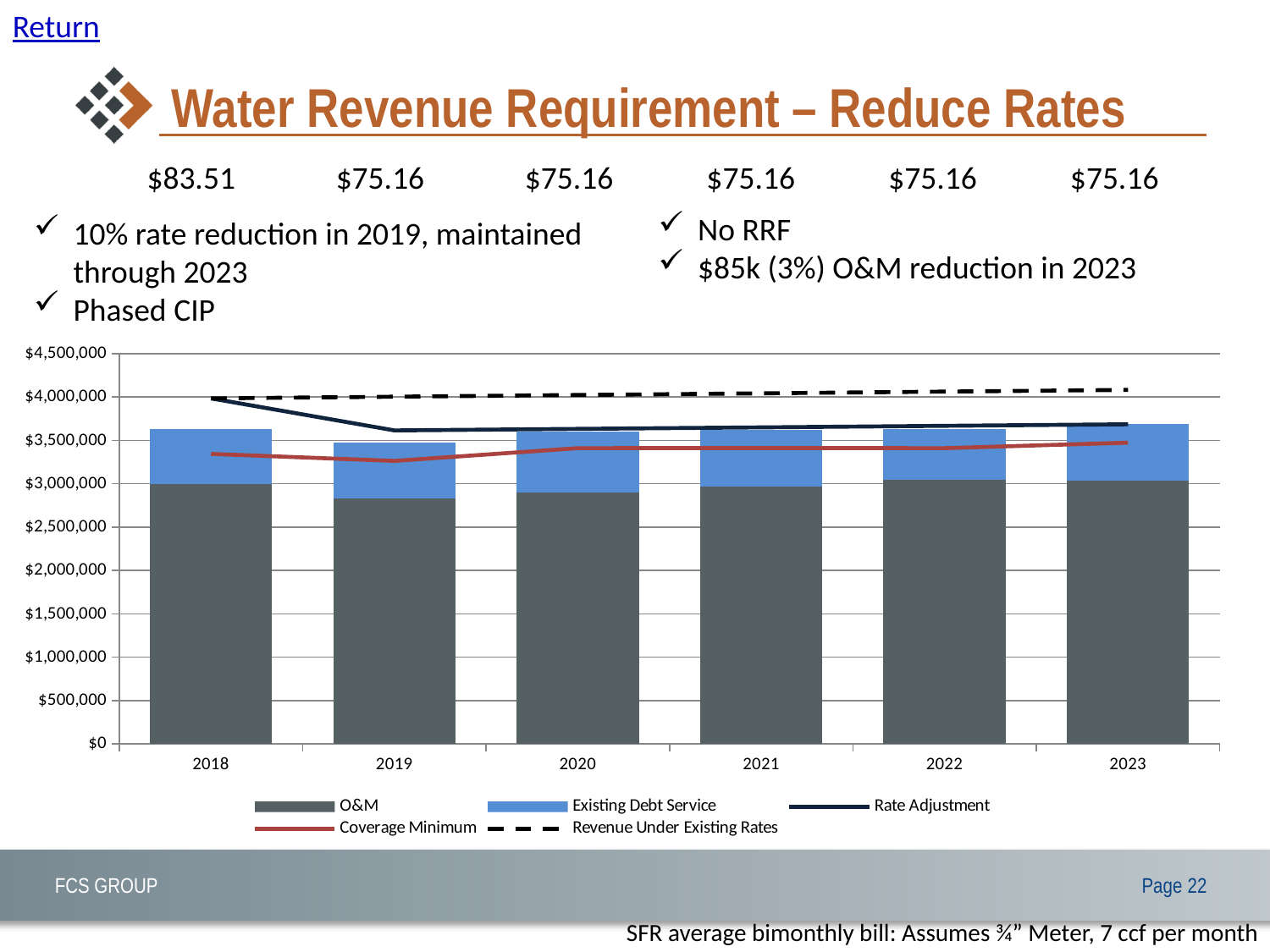
How many series does the chart legend list? 5 What kind of chart is shown on the slide? combination bar and line chart Which is larger, the O&M value for 2019 or for 2022? 2022 Which year has the lowest total stacked bar (O&M plus Existing Debt Service)? 2019 Which year has the lowest O&M value? 2019 Is the O&M value for 2019 greater or less than $3,000,000? less Is the Revenue Under Existing Rates value for 2023 greater or less than $4,000,000? greater How many years are shown on the x axis of the chart? 6 Which series is drawn as a dashed line in the chart? Revenue Under Existing Rates Is the total stacked bar for 2023 greater or less than $3,500,000? greater